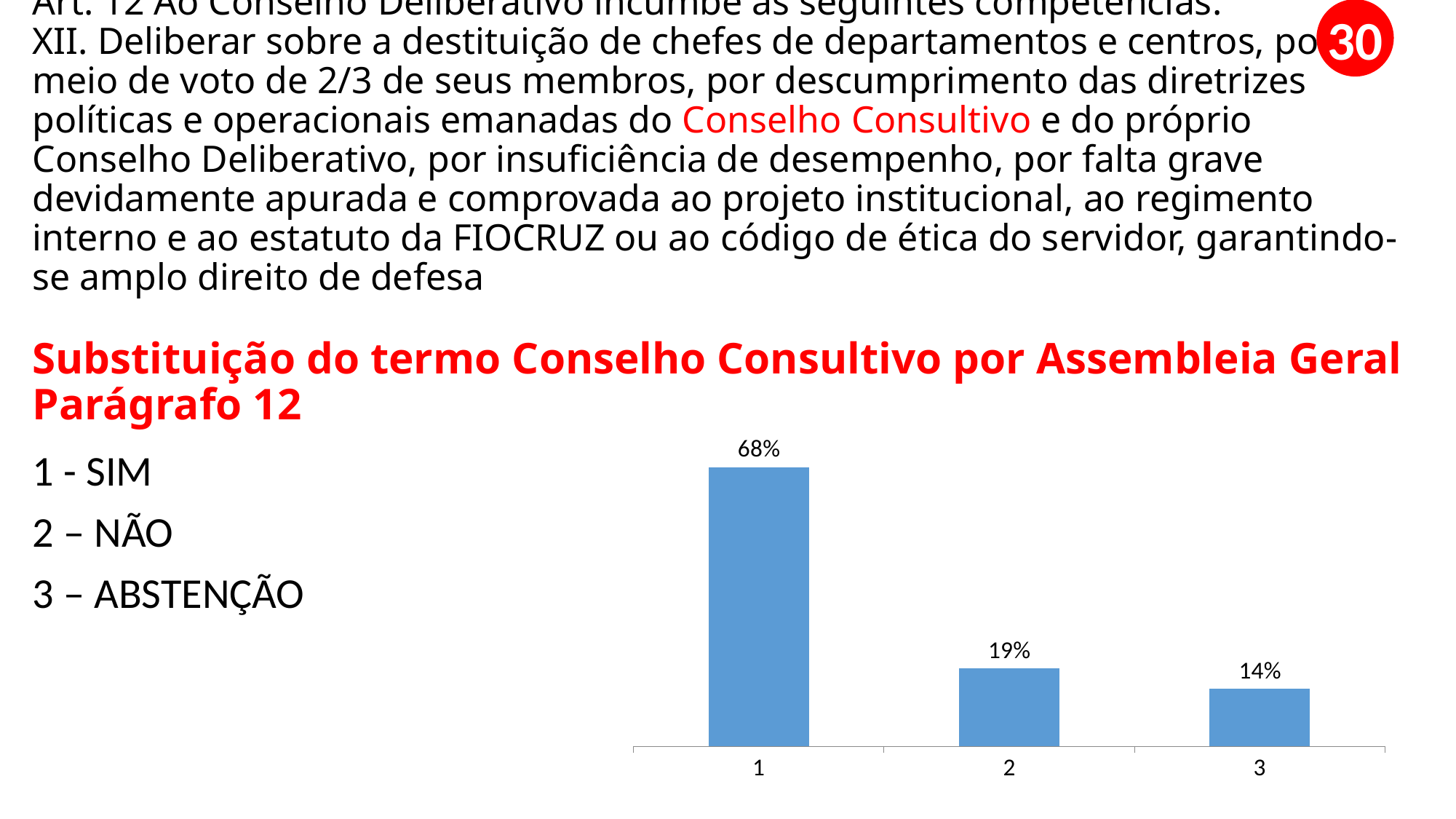
What is the difference between the values for category 2 and category 3? 5% Which is larger, the value for category 2 or category 3? 2 What kind of chart is shown on the slide? bar chart What is the value shown for category 3 in the bar chart? 14% Do the values rise or fall from category 1 to category 3? fall Which category has the lowest value in the bar chart? 3 What is the value shown for category 2 in the bar chart? 19% What is the difference between the values for category 1 and category 2? 49% What is the value shown for category 1 in the bar chart? 68% Which category has the highest value in the bar chart? 1 How many categories are shown on the x axis of the bar chart? 3 What colour are the bars in the chart? blue